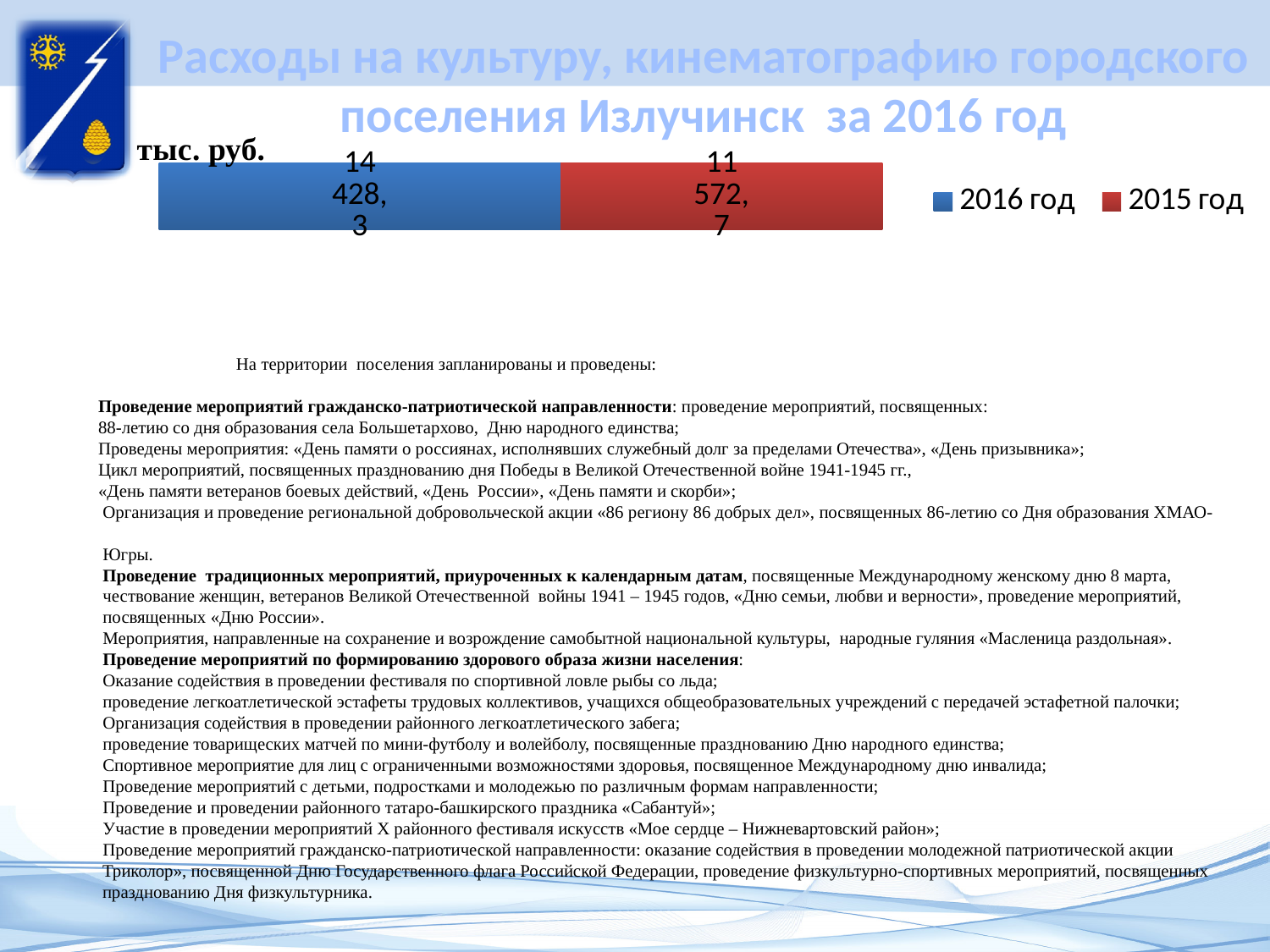
How many series does the legend list? 2 What unit of measurement is indicated for the chart values? тыс. руб. Which year has the higher value on the chart, 2016 год or 2015 год? 2016 год Which series has the highest value on the chart? 2016 год What kind of chart is shown on the slide? bar chart What colour represents 2015 год in the chart? red What is the value for 2015 год on the chart? 11 572,7 Which series has the lowest value on the chart? 2015 год What is the difference between the values for 2016 год and 2015 год? 2 855,6 What is the value for 2016 год on the chart? 14 428,3 What is the total of the stacked bar (2016 год plus 2015 год)? 26 001,0